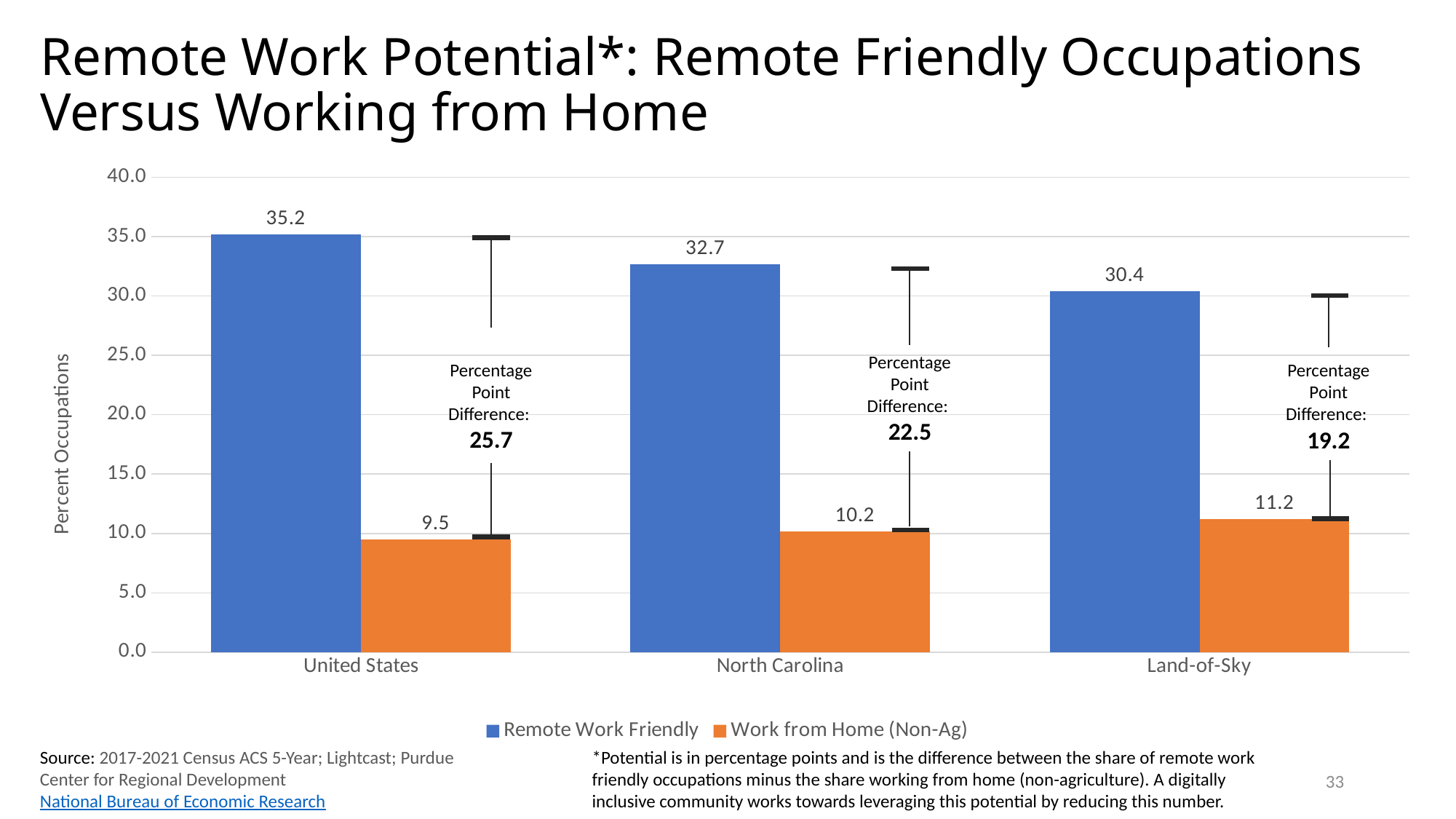
What is the Work from Home (Non-Ag) value for North Carolina? 10.2 What is the label of the y axis? Percent Occupations Which region has the highest Remote Work Friendly value? United States How many regions are shown on the x axis? 3 How many series does the legend list? 2 Which is larger: the Remote Work Friendly value for North Carolina or for Land-of-Sky? North Carolina Which region has the lowest Work from Home (Non-Ag) value? United States What is the difference between the Remote Work Friendly values for the United States and Land-of-Sky? 4.8 What kind of chart is shown on the slide? Bar chart What is the Work from Home (Non-Ag) value for Land-of-Sky? 11.2 What is the Remote Work Friendly value for the United States? 35.2 What is the percentage point difference between Remote Work Friendly and Work from Home (Non-Ag) for North Carolina? 22.5